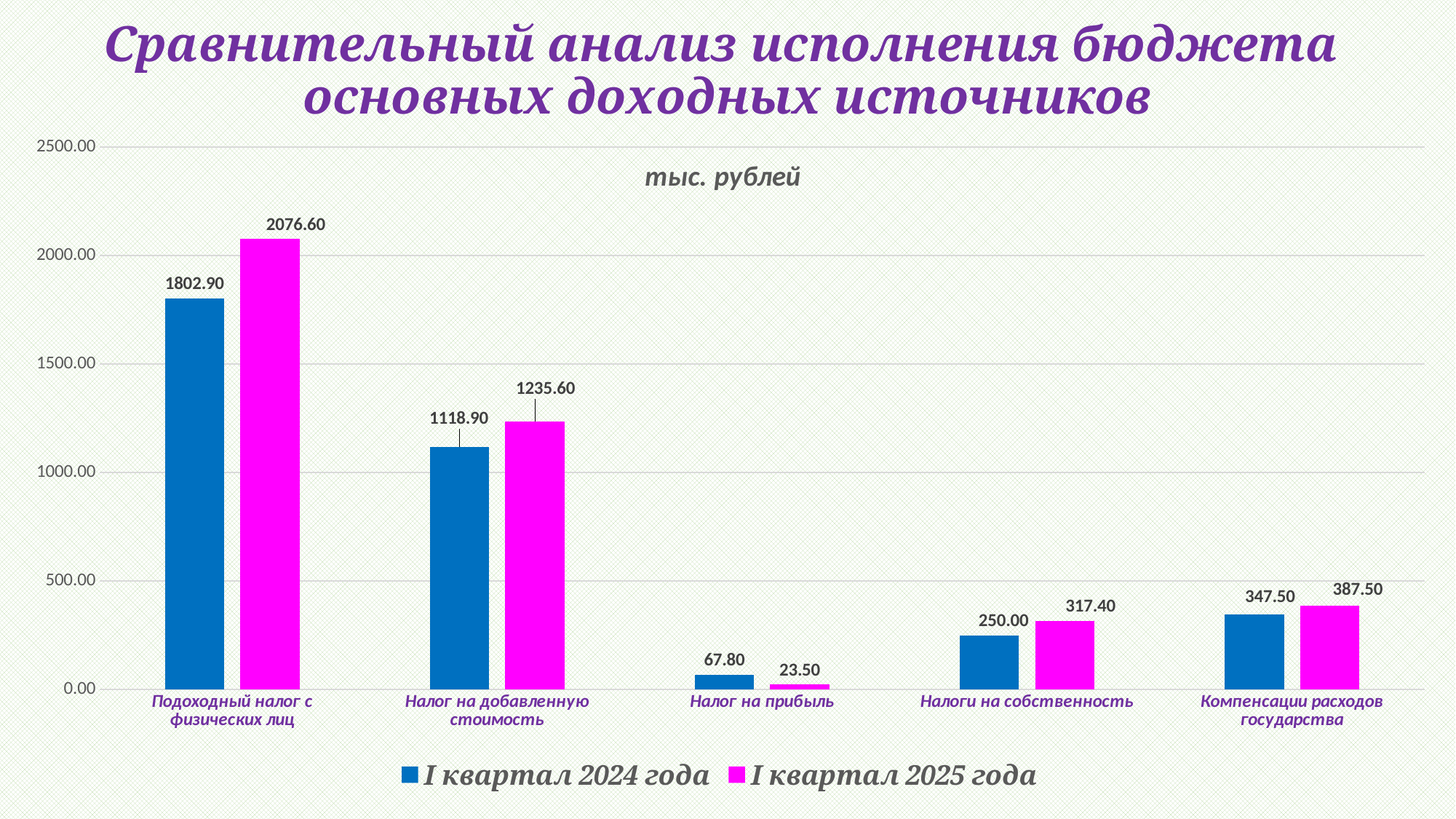
What is the value for Налоги на собственность in I квартал 2025 года? 317.40 Which is larger for Компенсации расходов государства: I квартал 2024 года or I квартал 2025 года? I квартал 2025 года What kind of chart is shown on the slide? bar chart What is the value for Подоходный налог с физических лиц in I квартал 2025 года? 2076.60 What is the value for Налог на прибыль in I квартал 2024 года? 67.80 How many series does the legend list? 2 What is the difference between the I квартал 2025 года and I квартал 2024 года values for Налог на добавленную стоимость? 116.70 Is the value for Налог на добавленную стоимость in I квартал 2024 года greater or less than 1000.00? greater Which category has the lowest value in I квартал 2025 года? Налог на прибыль How many categories are shown on the x axis? 5 What is the difference between the I квартал 2024 года and I квартал 2025 года values for Налог на прибыль? 44.30 Which category has the highest value in I квартал 2024 года? Подоходный налог с физических лиц